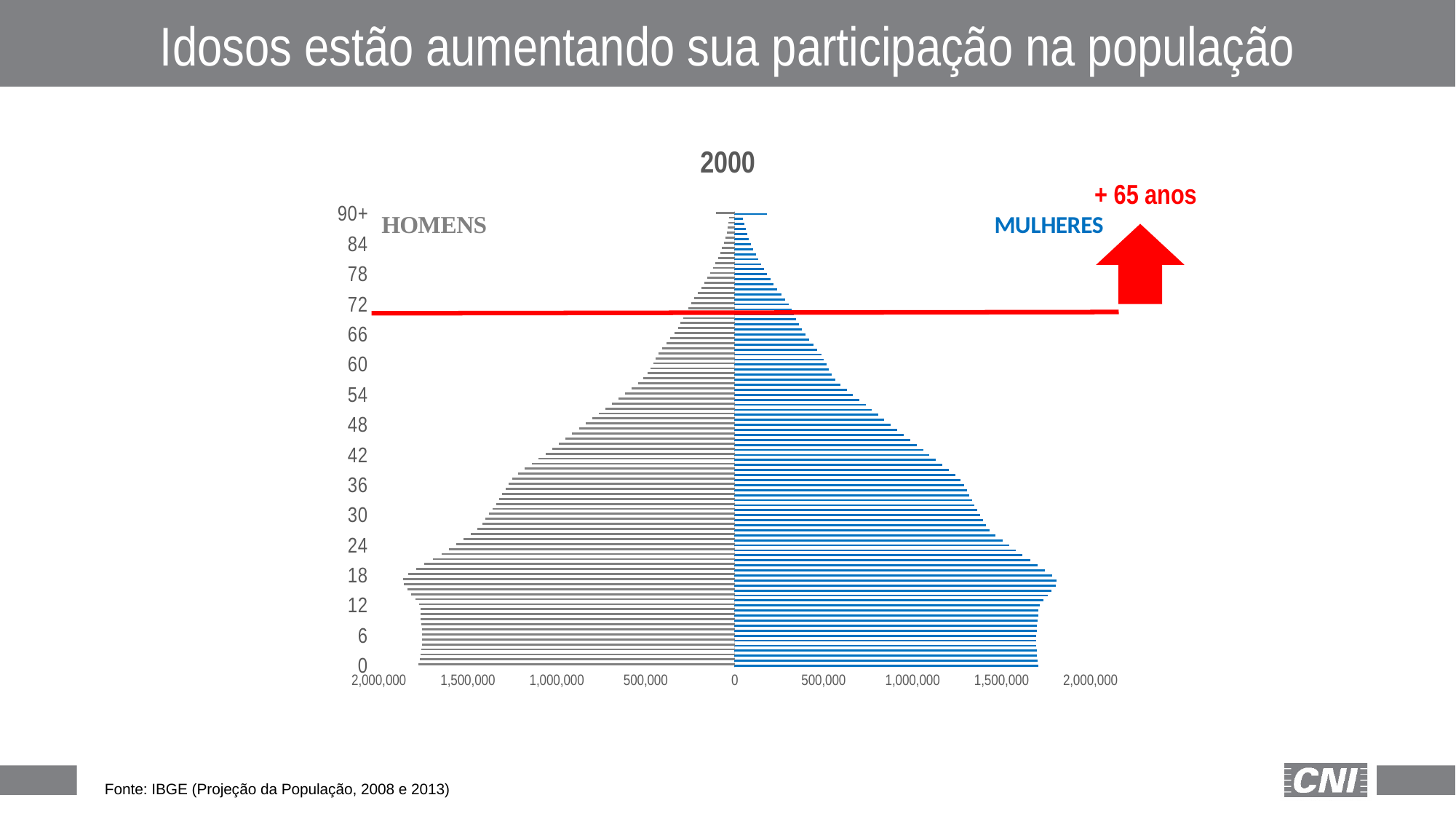
What is the title of the chart? 2000 Is the value for MULHERES at age 0 greater or less than 1,500,000? greater Is the value for HOMENS at age 18 greater or less than 1,500,000? greater Is the value for HOMENS at age 48 greater or less than 1,000,000? less Which two groups are plotted in the chart? HOMENS and MULHERES Do the bars for HOMENS get longer or shorter as age increases from 24 to 90+? shorter What is the largest value shown on the horizontal axis? 2,000,000 What kind of chart is shown on the slide? bar chart